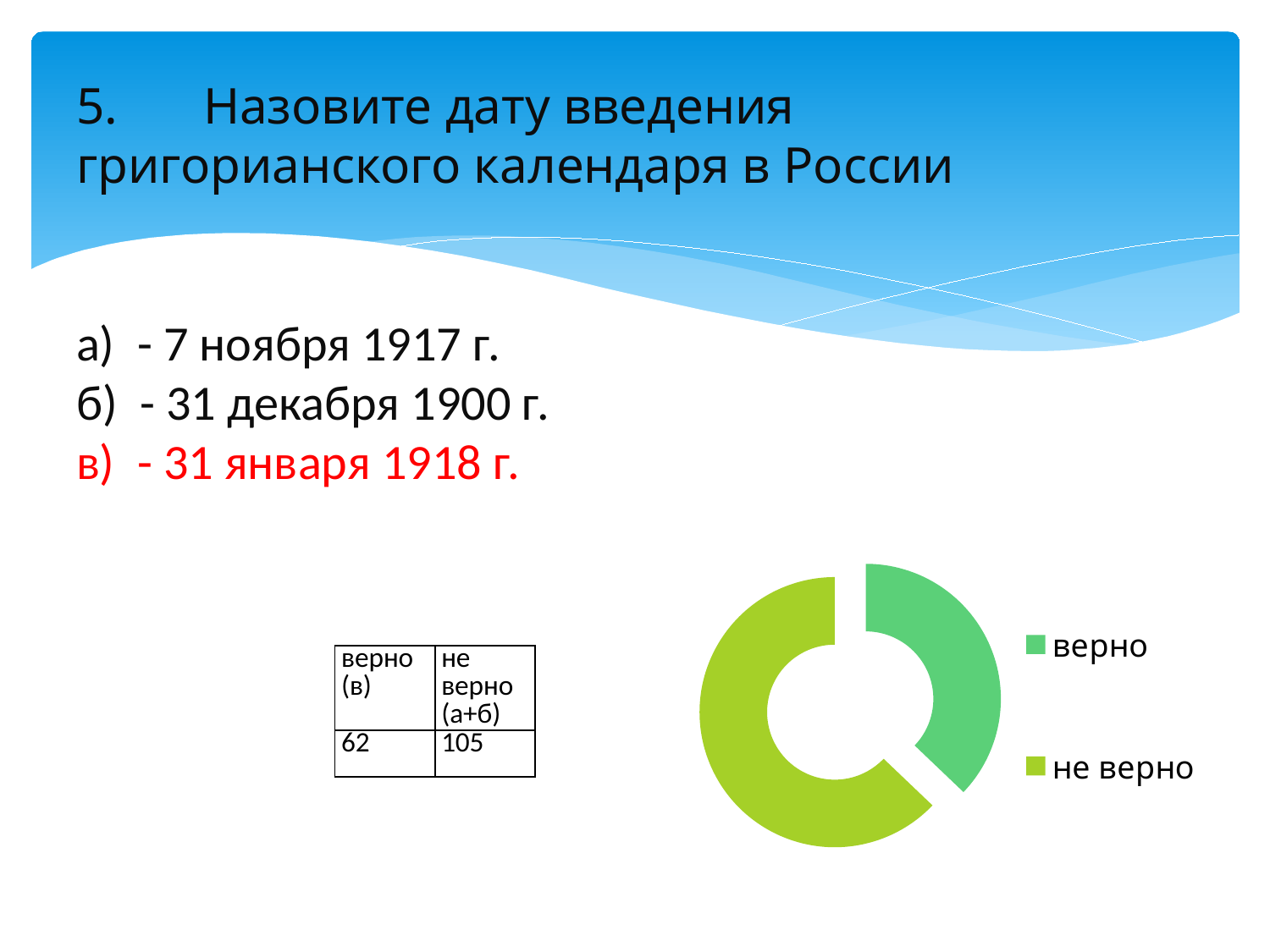
What kind of chart is shown on the slide? doughnut chart Which legend entry is shown in the lighter yellow-green colour? не верно What are the two legend entries of the doughnut chart? верно, не верно Is the share for "верно" larger or smaller than the share for "не верно"? smaller According to the table on the slide, what is the value for "не верно (а+б)"? 105 Which category takes the smaller share of the doughnut chart? верно How many entries does the legend of the doughnut chart list? 2 How many categories does the doughnut chart show? 2 What is the total of the two values shown in the table (верно and не верно)? 167 According to the table on the slide, what is the value for "верно (в)"? 62 Which category takes the larger share of the doughnut chart? не верно By how much does the value for "не верно" exceed the value for "верно" in the table? 43